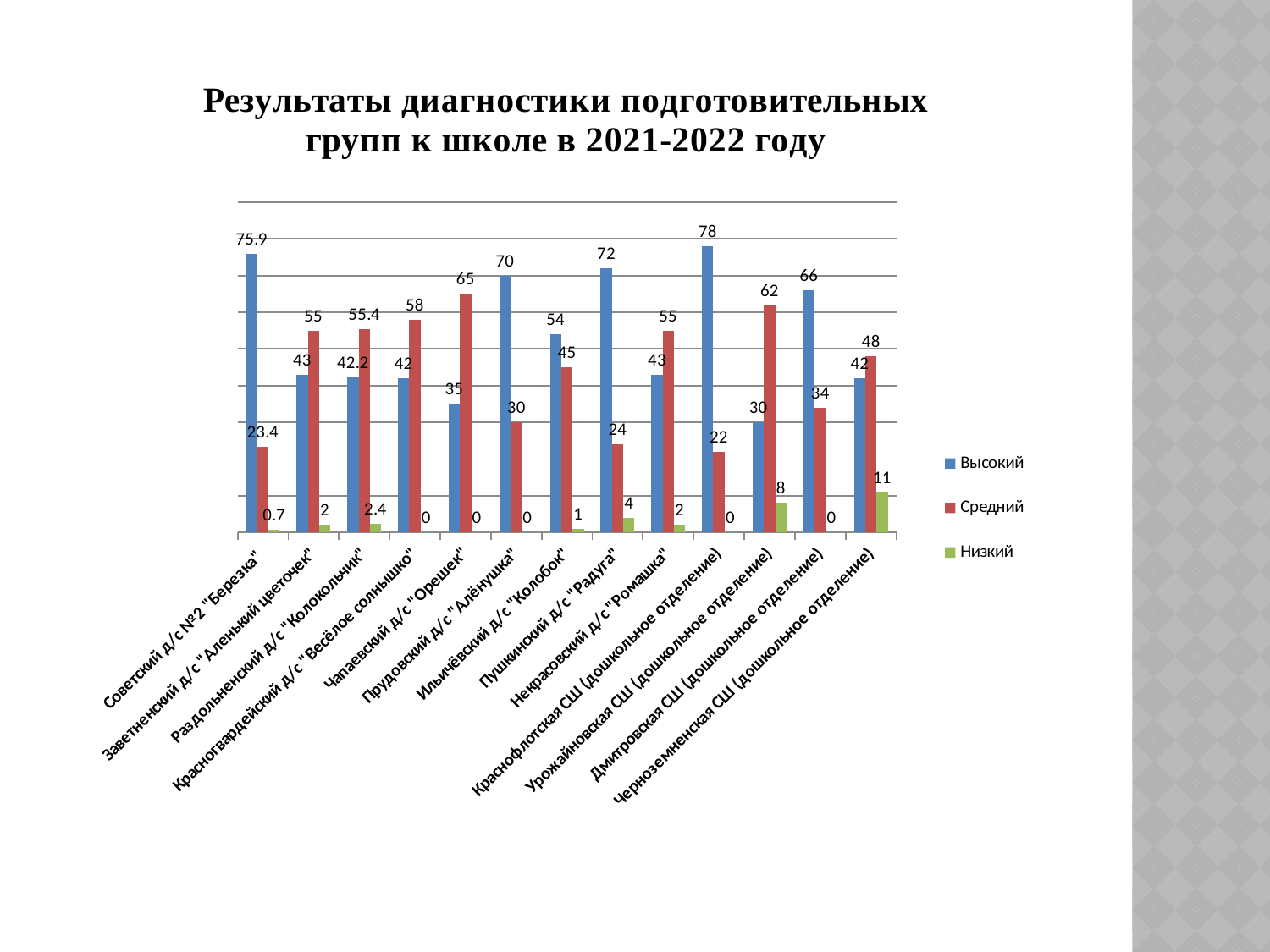
What is the value of the Средний series for Чапаевский д/с "Орешек"? 65 What is the difference between the Высокий and Средний values for Прудовский д/с "Алёнушка"? 40 What is the value of the Низкий series for Урожайновская СШ (дошкольное отделение)? 8 How many categories are shown on the x axis? 13 Which category has the highest value in the Высокий series? Краснофлотская СШ (дошкольное отделение) What is the total of the three values for Советский д/с №2 "Березка"? 100 What kind of chart is shown on the slide? Bar chart Which category has the lowest value in the Высокий series? Урожайновская СШ (дошкольное отделение) What is the value of the Высокий series for Краснофлотская СШ (дошкольное отделение)? 78 Which category has the highest value in the Низкий series? Черноземненская СШ (дошкольное отделение) For Ильичёвский д/с "Колобок", which is larger: the Высокий value or the Средний value? Высокий How many series does the legend list? 3